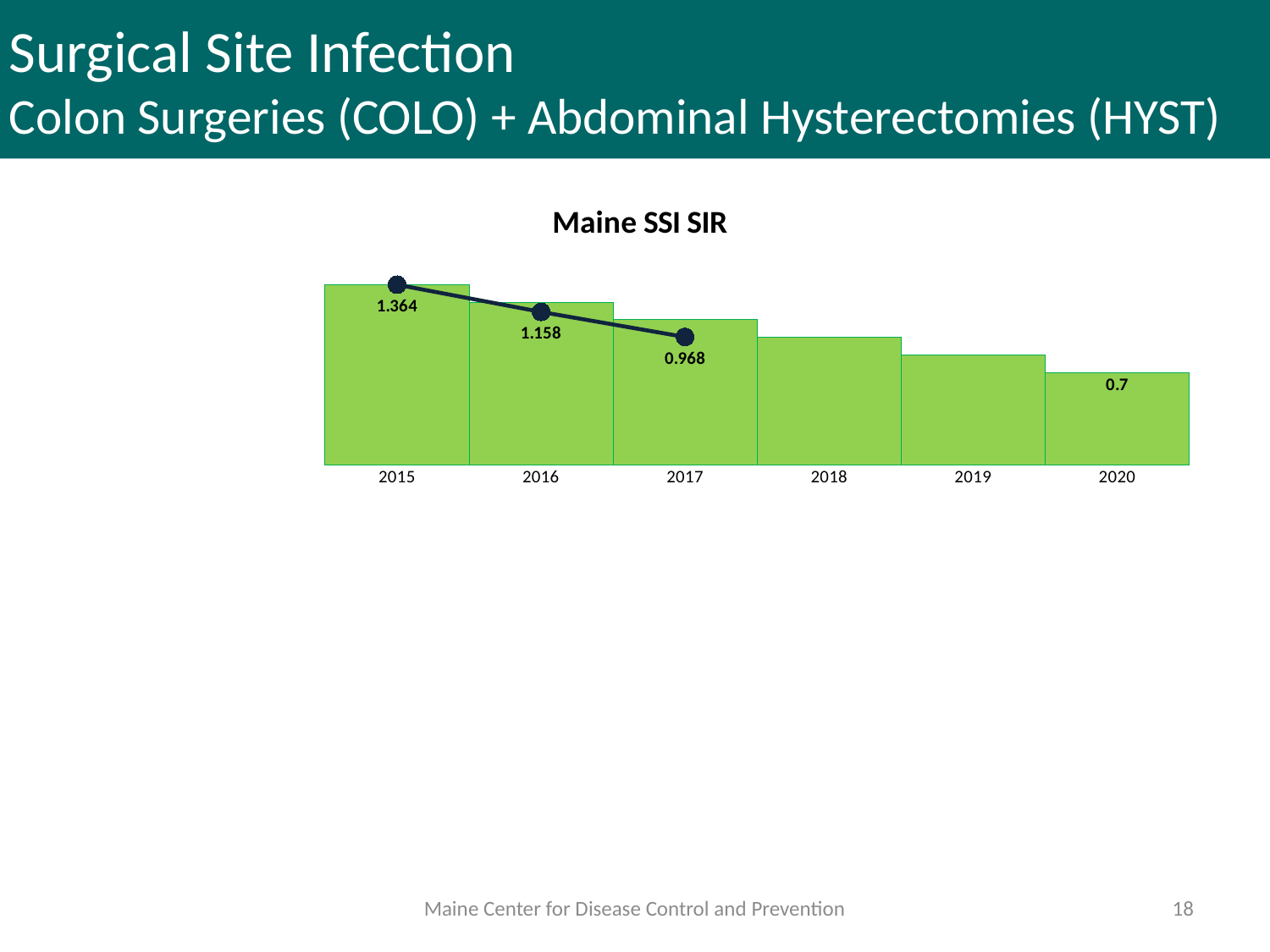
How many years are shown on the x axis of the Maine SSI SIR chart? 6 What is the title of the chart on the slide? Maine SSI SIR Which year has the lowest value in the Maine SSI SIR chart? 2020 Which year has the highest value in the Maine SSI SIR chart? 2015 Do the values in the Maine SSI SIR chart rise or fall from 2015 to 2020? fall What is the value for 2020 in the Maine SSI SIR chart? 0.7 Which is larger in the Maine SSI SIR chart, the value for 2018 or the value for 2020? 2018 What is the difference between the 2015 and 2016 values in the Maine SSI SIR chart? 0.206 What is the difference between the 2015 and 2020 values in the Maine SSI SIR chart? 0.664 What is the value for 2017 in the Maine SSI SIR chart? 0.968 What is the value for 2016 in the Maine SSI SIR chart? 1.158 What is the value for 2015 in the Maine SSI SIR chart? 1.364